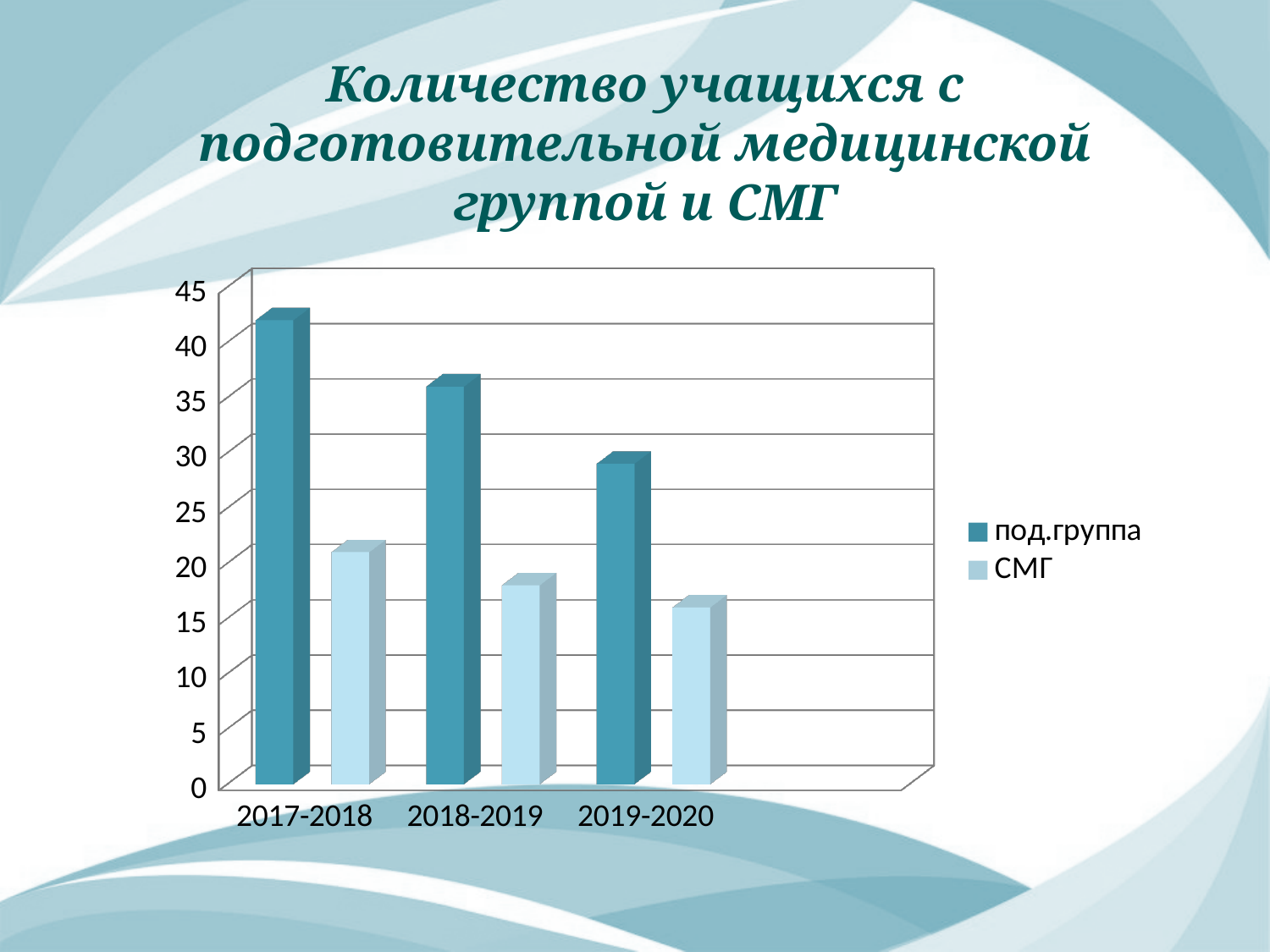
How many categories (school years) are shown on the x axis? 3 Do the СМГ values rise or fall from 2017-2018 to 2019-2020? fall In which school year is the под.группа value highest? 2017-2018 Is the СМГ value for 2018-2019 greater or less than 20? less What kind of chart is shown on the slide? bar chart What are the two entries listed in the chart legend? под.группа and СМГ Is the под.группа value for 2019-2020 greater or less than 35? less Do the под.группа values rise or fall from 2017-2018 to 2019-2020? fall Which is larger in 2017-2018, под.группа or СМГ? под.группа In which school year is the СМГ value lowest? 2019-2020 Is the под.группа value for 2017-2018 greater or less than 40? greater How many series does the legend list? 2